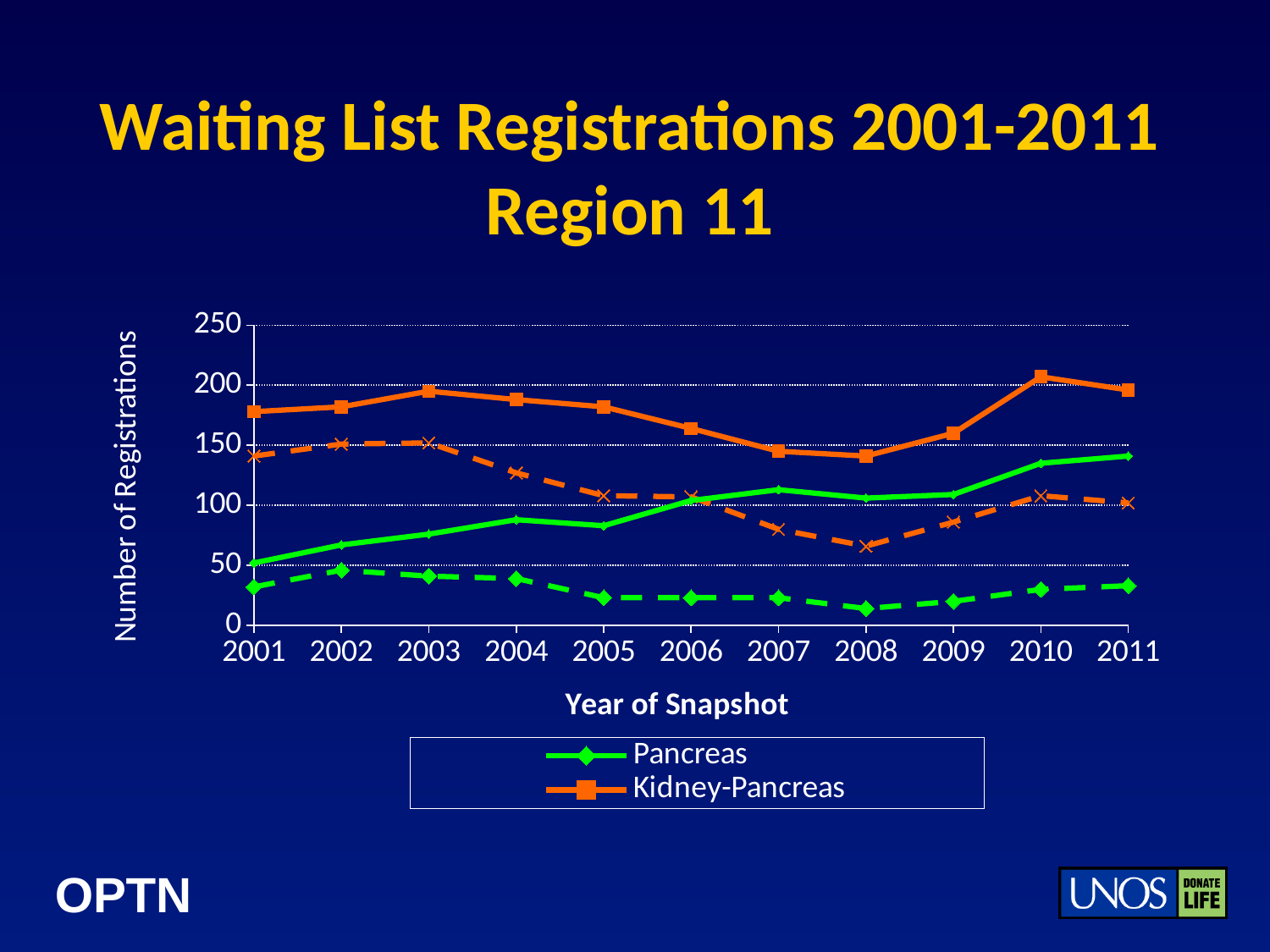
Is the Pancreas value for 2003 greater or less than 100? less Is the Kidney-Pancreas value for 2008 greater or less than 150? less In which year is the Kidney-Pancreas value highest? 2010 How many series does the legend list? 2 Is the Pancreas value for 2011 greater or less than 100? greater How many years are shown on the x axis? 11 What is the title of the x axis? Year of Snapshot In which year is the Pancreas value lowest? 2001 What kind of chart is shown on the slide? line chart Does the Pancreas series rise or fall overall from 2001 to 2011? rise In 2001, which series has the larger value, Pancreas or Kidney-Pancreas? Kidney-Pancreas